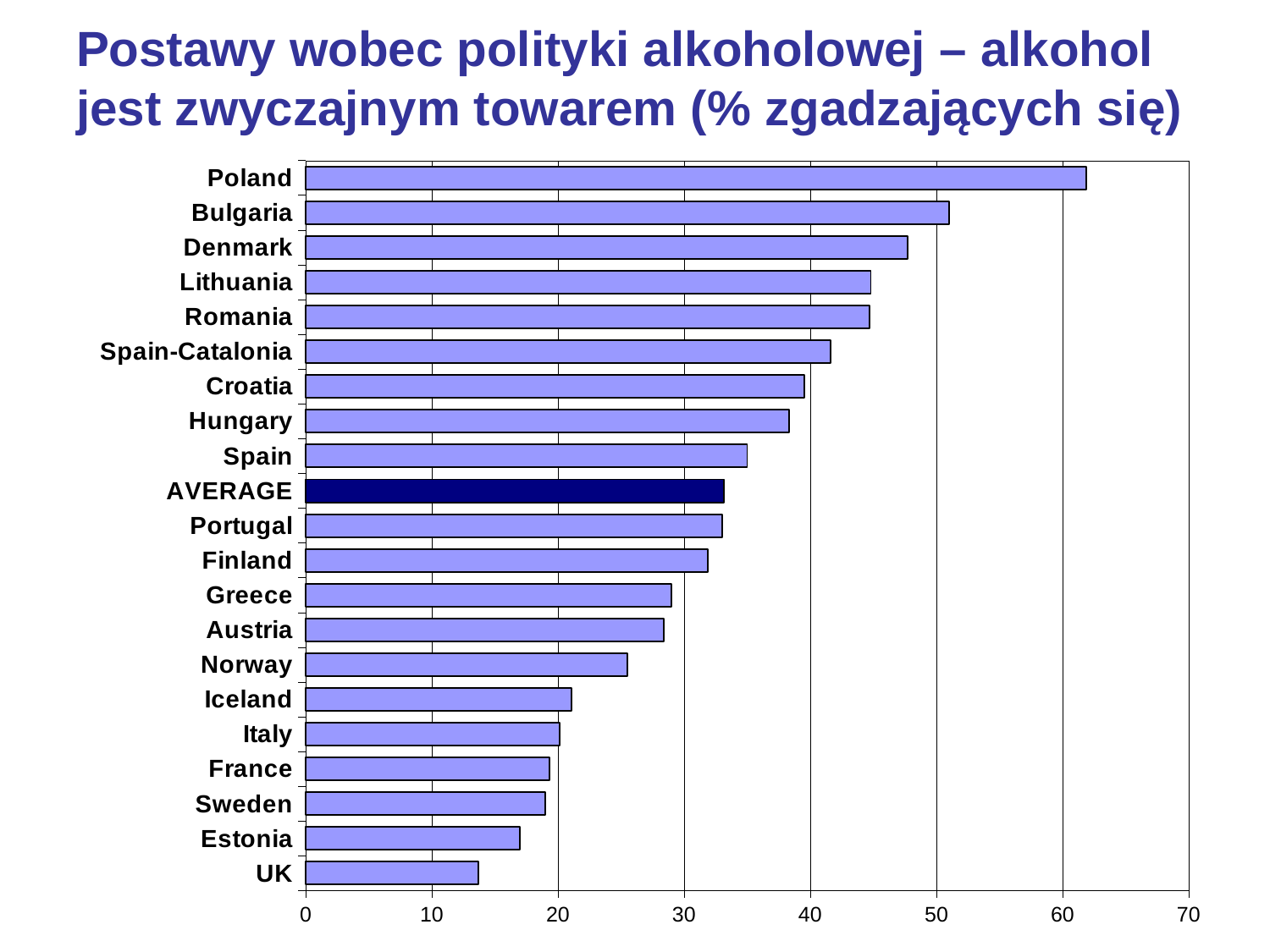
Is the value for Norway greater or less than 20? greater How many bars (categories) are shown in the chart? 21 Which country has the lowest value in the chart? UK Which has a larger value, Denmark or Lithuania? Denmark Is the value for Denmark greater or less than 50? less What kind of chart is shown on the slide? bar chart Is the value for UK greater or less than 20? less Which country has the highest value in the chart? Poland Which bar is drawn in a darker colour than the others? AVERAGE Which has a larger value, Poland or Bulgaria? Poland